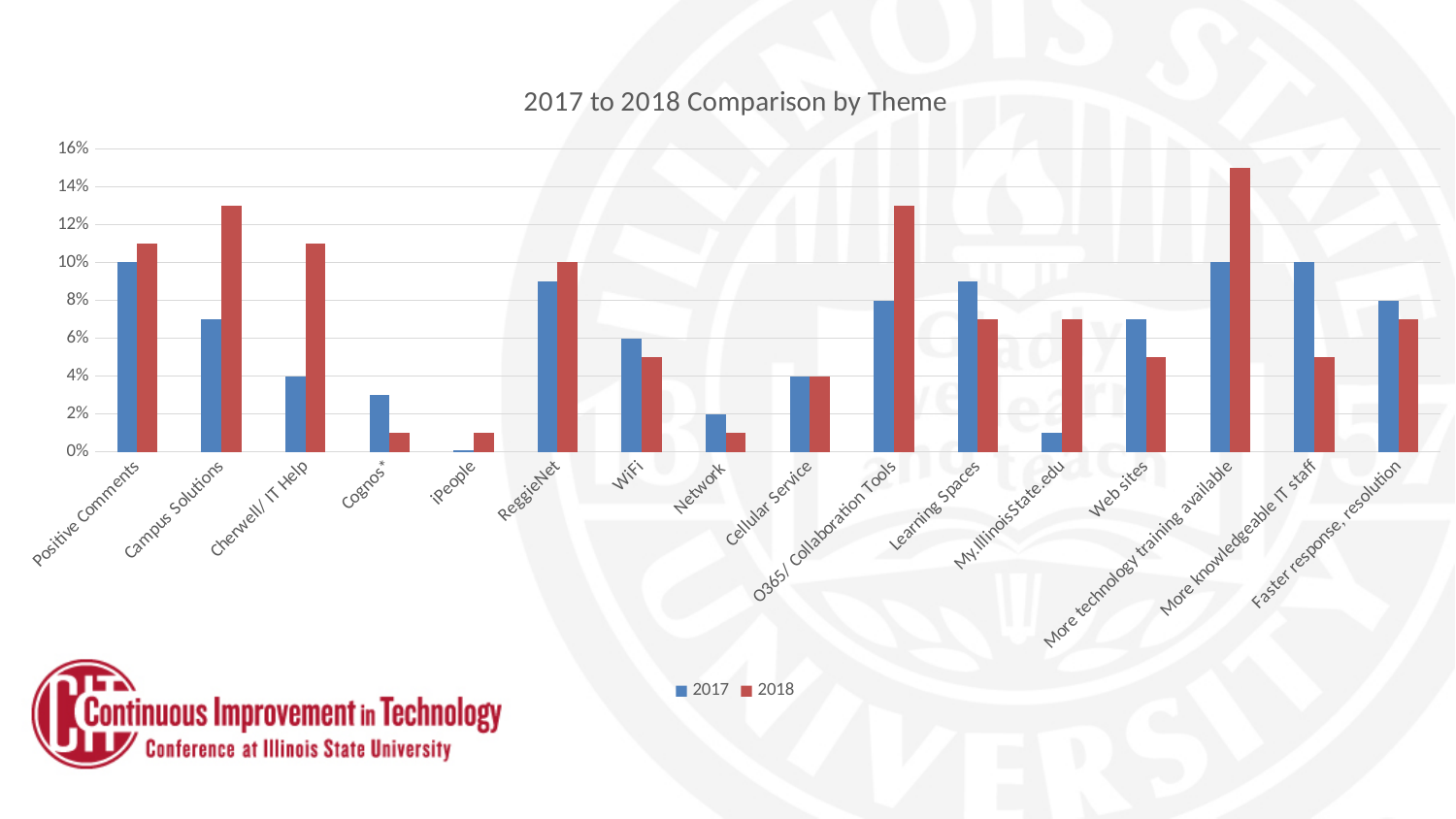
Is the 2018 value for Campus Solutions greater or less than 12%? greater Which theme has the lowest 2017 value? iPeople Which is larger for Cherwell/ IT Help, the 2017 value or the 2018 value? 2018 Which is larger for More knowledgeable IT staff, the 2017 value or the 2018 value? 2017 Which theme has the highest 2018 value? More technology training available What is the title of the chart? 2017 to 2018 Comparison by Theme Is the 2018 value for Cognos* greater or less than 2%? less What type of chart is shown on the slide? bar chart How many theme categories are shown along the x axis? 16 What is the 2017 value for Cellular Service? 4% How many series does the legend list? 2 What is the 2017 value for Positive Comments? 10%